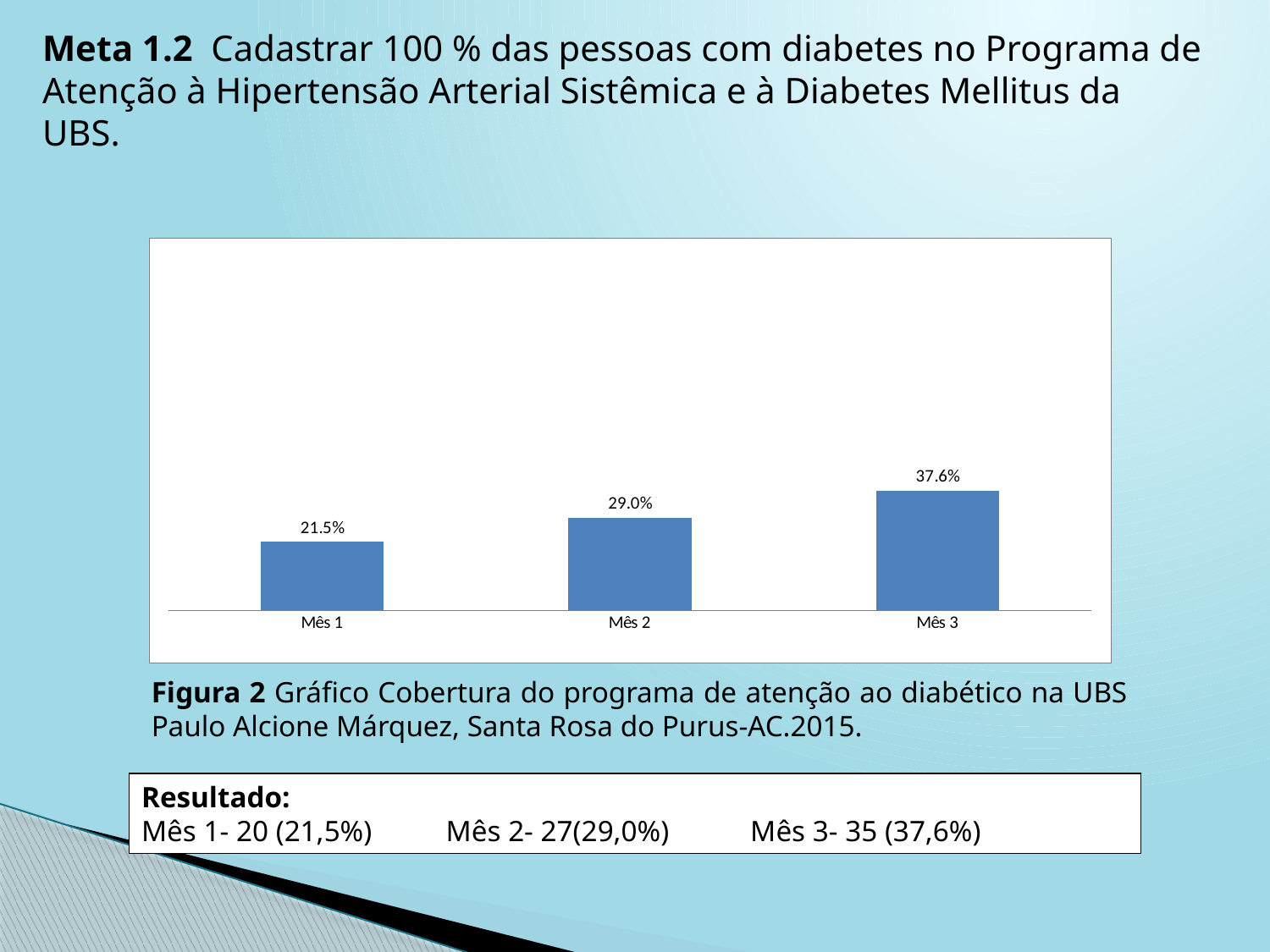
What kind of chart is shown on the slide? Bar chart What is the value for Mês 3? 37.6% What is the difference between the values for Mês 2 and Mês 1? 7.5% Do the values rise or fall from Mês 1 to Mês 3? Rise What is the value for Mês 2? 29.0% Which month has the lowest value? Mês 1 What is the difference between the values for Mês 3 and Mês 1? 16.1% Which is larger, the value for Mês 2 or the value for Mês 3? Mês 3 What is the value for Mês 1? 21.5% How many categories are shown on the x axis? 3 What colour are the bars in the chart? Blue Which month has the highest value? Mês 3